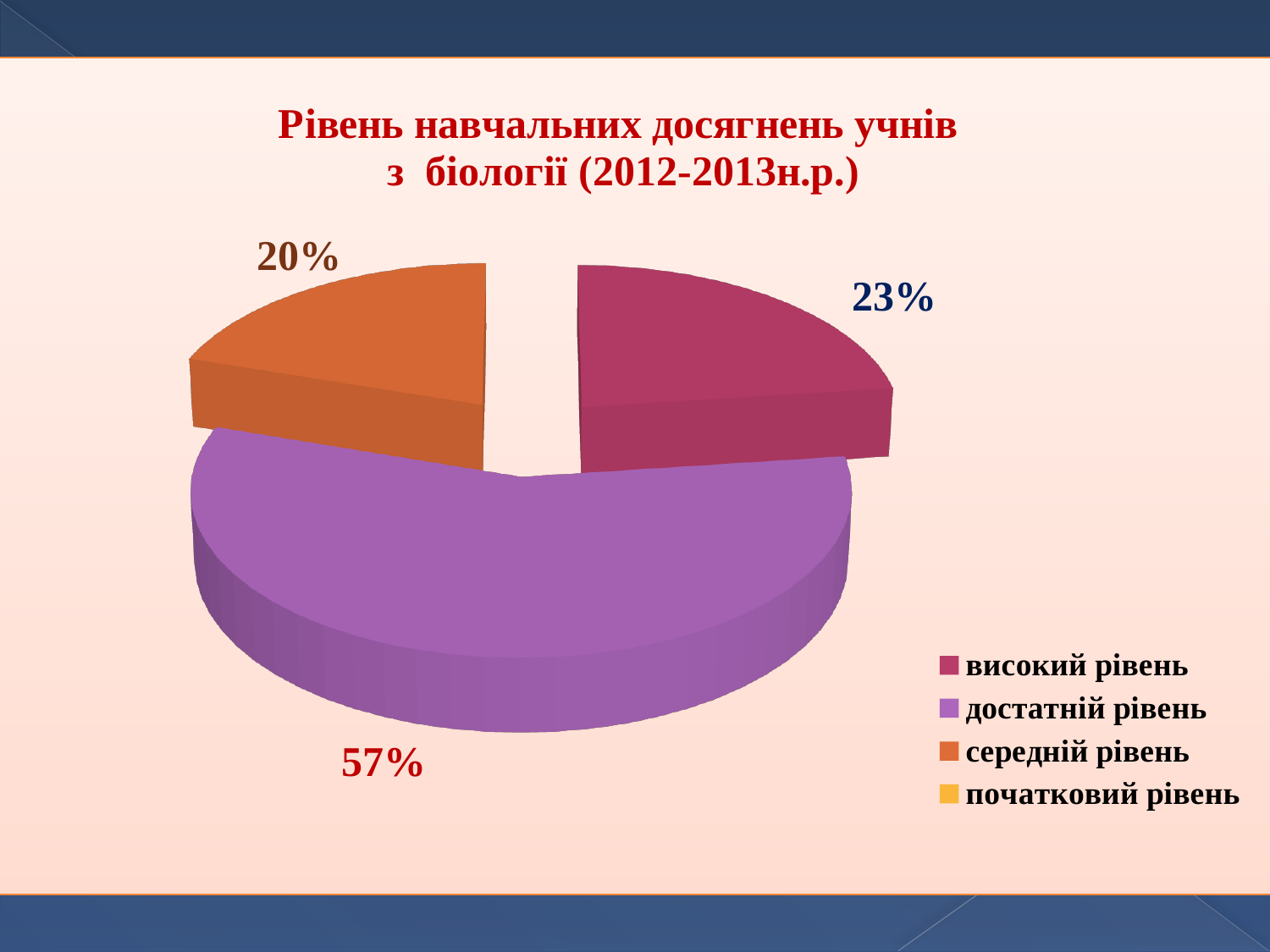
What is the difference in percentage points between високий рівень and середній рівень? 3 How many entries does the legend list? 4 Which school year is named in the chart title? 2012-2013н.р. What colour is the slice for достатній рівень? purple What percentage is shown for достатній рівень? 57% What percentage is shown for середній рівень? 20% Which is larger, the slice for високий рівень or the slice for середній рівень? високий рівень What percentage is shown for високий рівень? 23% How many slices with data labels are visible in the pie chart? 3 What type of chart is shown on the slide? pie chart What is the difference in percentage points between достатній рівень and високий рівень? 34 Which category has the largest slice of the pie? достатній рівень